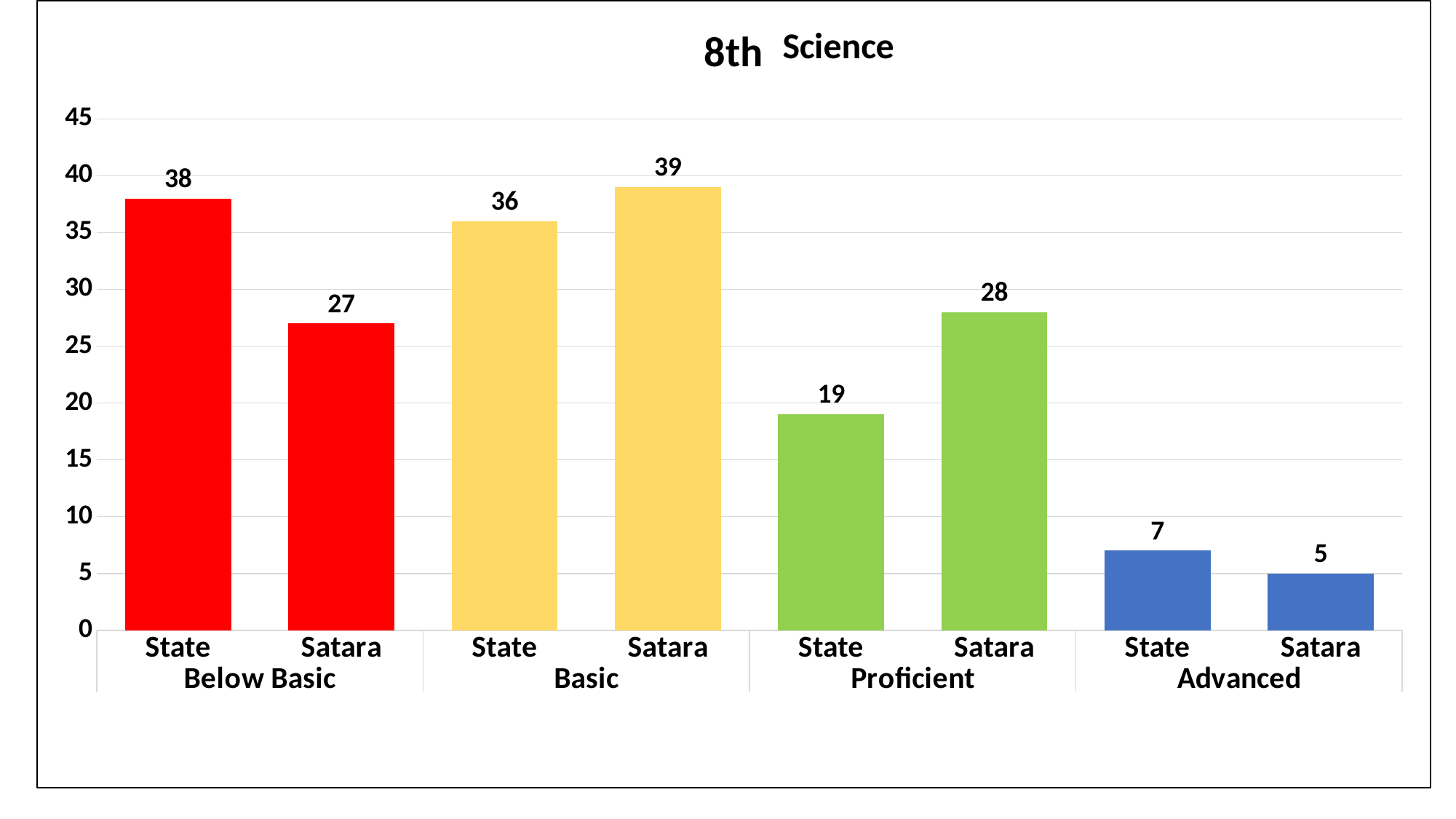
What is the value for Satara in the Advanced group? 5 What is the difference between Satara and State in the Proficient group? 9 What is the title of the chart? 8th Science What is the difference between State and Satara in the Below Basic group? 11 In the Basic group, which is larger, State or Satara? Satara What is the value for State in the Below Basic group? 38 What kind of chart is shown on the slide? Bar chart In the Advanced group, which is larger, State or Satara? State Which bar has the highest value on the chart? Satara, Basic How many bars are plotted on the chart? 8 Which bar has the lowest value on the chart? Satara, Advanced What is the value for Satara in the Proficient group? 28